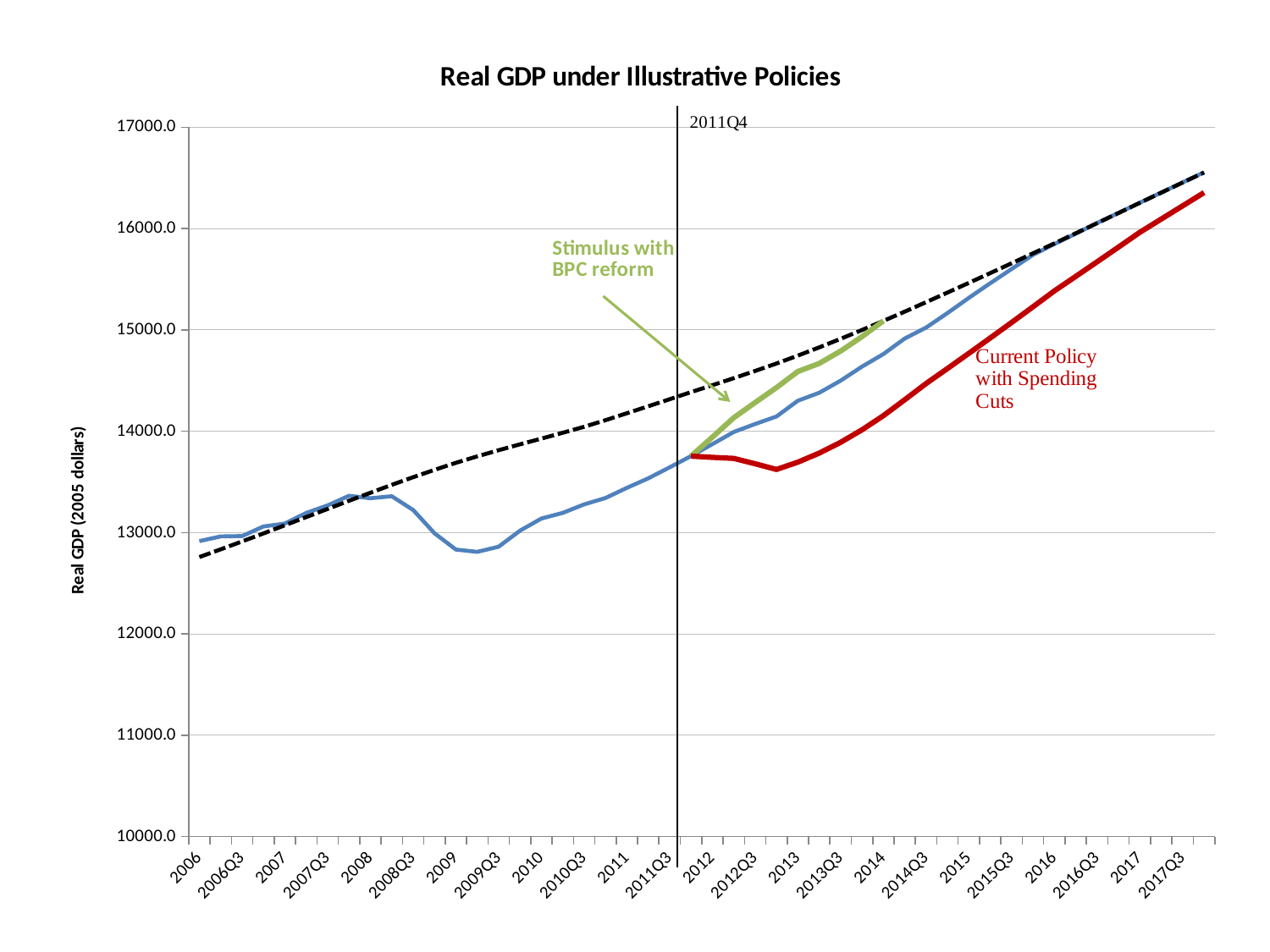
Is the value of the black dashed line at 2006 greater or less than 13000.0? less Does the red 'Current Policy with Spending Cuts' line rise or fall from 2014 to 2017Q3? rise Is the value of the blue line at 2009Q3 greater or less than 13000.0? less Does the blue line rise or fall from 2008 to 2009? fall What is the title of the chart? Real GDP under Illustrative Policies Is the value of the green 'Stimulus with BPC reform' line at 2013 greater or less than 14000.0? greater At 2016, which line is higher: the blue line or the red 'Current Policy with Spending Cuts' line? the blue line What kind of chart is shown on the slide? line chart Which quarter does the vertical black line on the chart mark? 2011Q4 At 2013, which line is higher: the green 'Stimulus with BPC reform' line or the red 'Current Policy with Spending Cuts' line? Stimulus with BPC reform